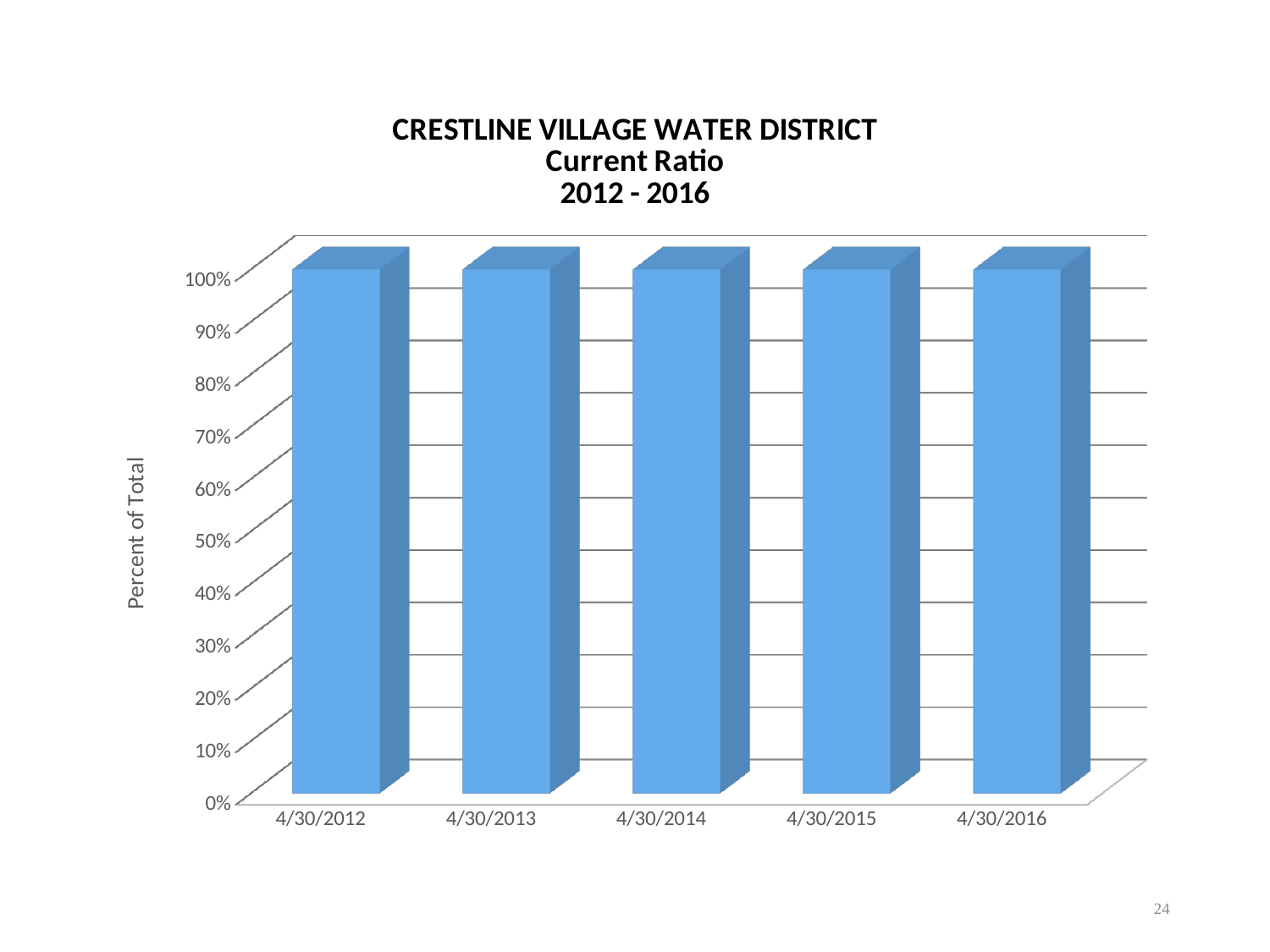
Is the value for 4/30/2015 greater or less than 60%? greater Is the value for 4/30/2014 greater or less than 50%? greater What is the title of the chart? CRESTLINE VILLAGE WATER DISTRICT Current Ratio 2012 - 2016 What is the first date shown on the horizontal axis? 4/30/2012 Is the value for 4/30/2013 greater or less than 70%? greater What is the label on the vertical axis? Percent of Total How many bars (dates) are plotted in the chart? 5 What is the highest tick value shown on the vertical axis? 100% What kind of chart is shown on the slide? bar chart